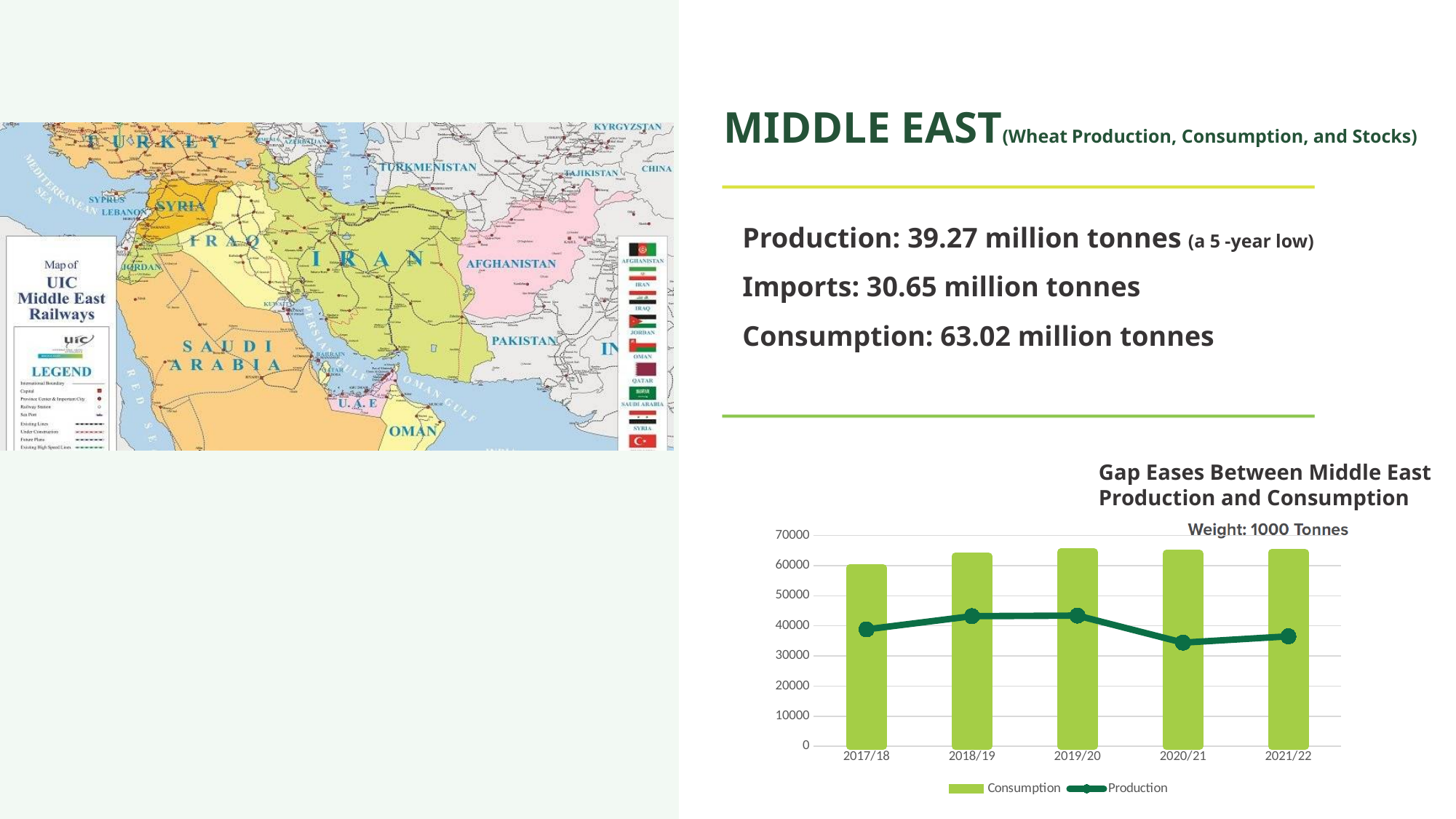
Which is larger in 2019/20, Consumption or Production? Consumption Which year has the larger Production value, 2017/18 or 2018/19? 2018/19 Is the Consumption value for 2018/19 greater or less than 60000? greater How many series does the chart legend list? 2 How many years are shown on the x axis of the chart? 5 Is the Production value for 2018/19 greater or less than 40000? greater Does the Production line rise or fall from 2019/20 to 2020/21? fall Is the Consumption value for 2021/22 greater or less than 70000? less What is the title of the chart on the slide? Gap Eases Between Middle East Production and Consumption Which series is drawn as bars in the chart? Consumption Which year has the lowest Consumption value in the chart? 2017/18